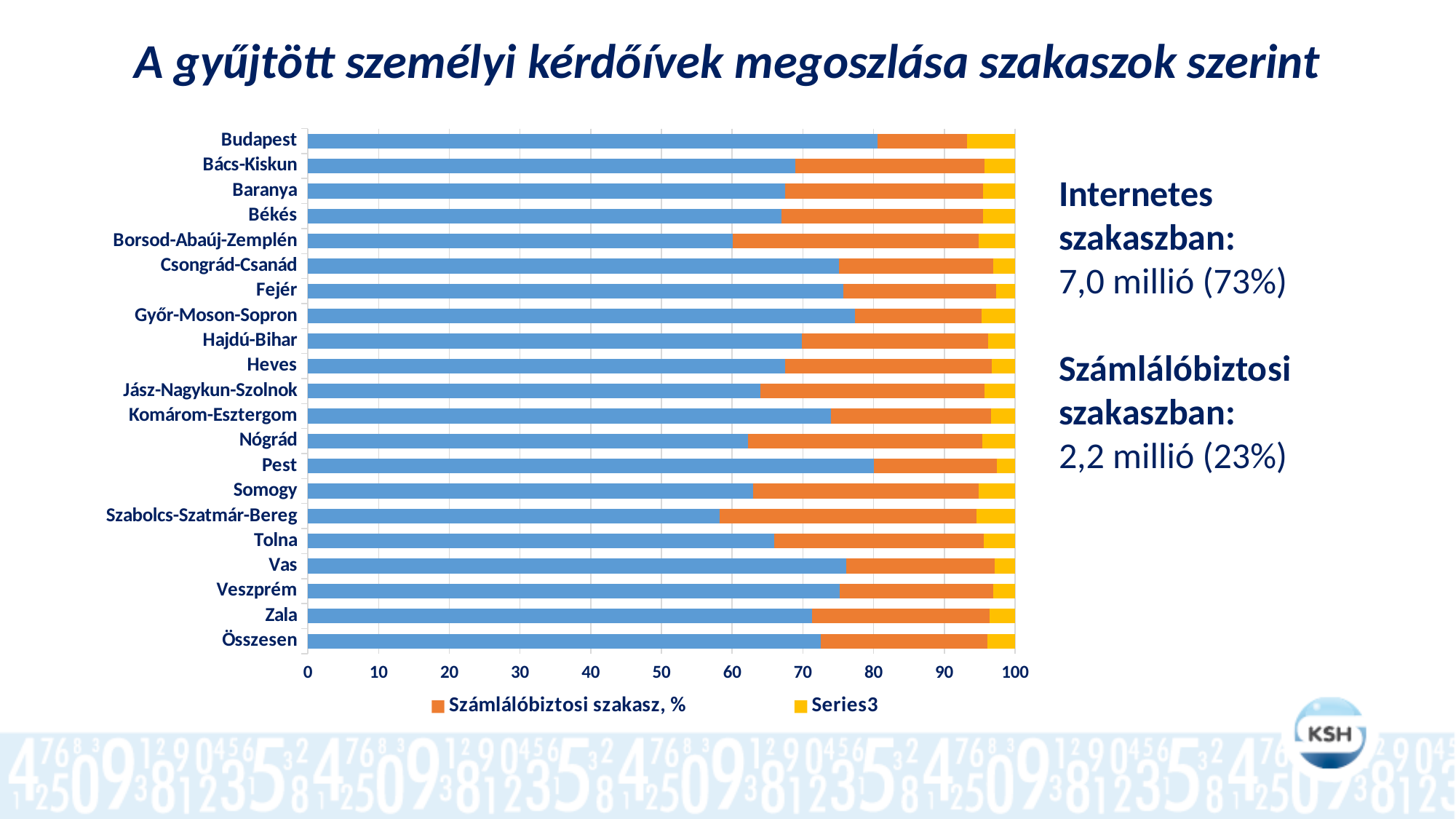
What kind of chart is shown on the slide? stacked bar chart What is the total of the stacked bar for Összesen? 100 Is the blue segment for Győr-Moson-Sopron greater or less than 70? greater Which has the larger blue segment, Budapest or Szabolcs-Szatmár-Bereg? Budapest Which legend entry is shown in orange? Számlálóbiztosi szakasz, % Is the blue segment for Budapest greater or less than 70? greater How many series does the chart legend list? 2 How many categories (rows) are plotted on the vertical axis of the chart? 21 Is the blue segment for Jász-Nagykun-Szolnok greater or less than 70? less What is the title of the chart on the slide? A gyűjtött személyi kérdőívek megoszlása szakaszok szerint Which has the larger blue segment, Csongrád-Csanád or Nógrád? Csongrád-Csanád